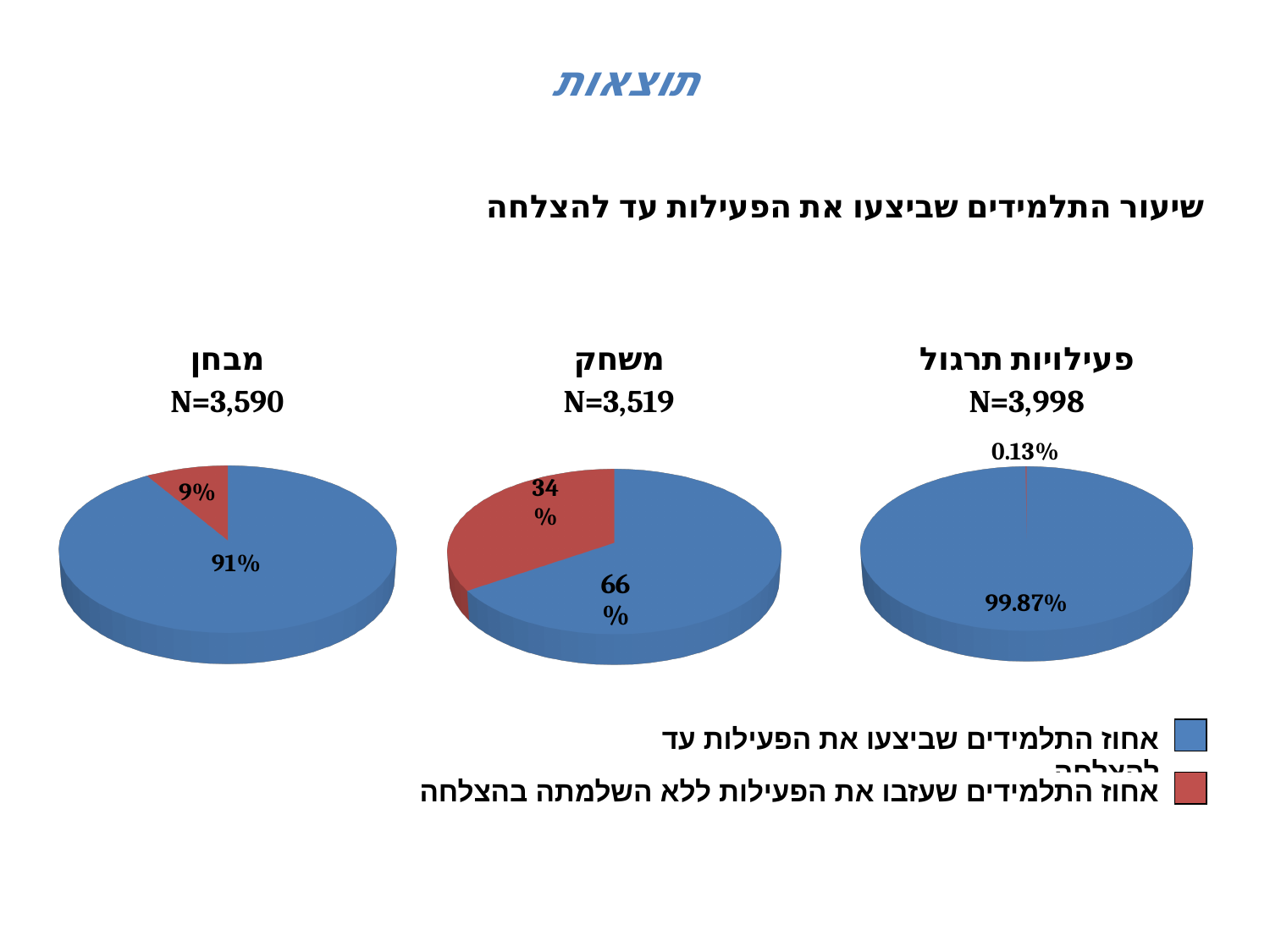
In the pie chart titled פעילויות תרגול, what share of students abandoned the activity without completing it successfully (red slice)? 0.13% In the pie chart titled משחק, what share of students completed the activity successfully (blue slice)? 66% In the pie chart titled פעילויות תרגול, what share of students completed the activity successfully (blue slice)? 99.87% What is the N value shown for the pie chart titled משחק? N=3,519 Which of the three pie charts has the largest red (abandoned) slice? משחק What is the N value shown for the pie chart titled פעילויות תרגול? N=3,998 In the pie chart titled משחק, what is the difference between the blue slice and the red slice? 32% Which of the three pie charts has the smallest red (abandoned) slice? פעילויות תרגול What kind of charts are shown on the slide? Pie charts